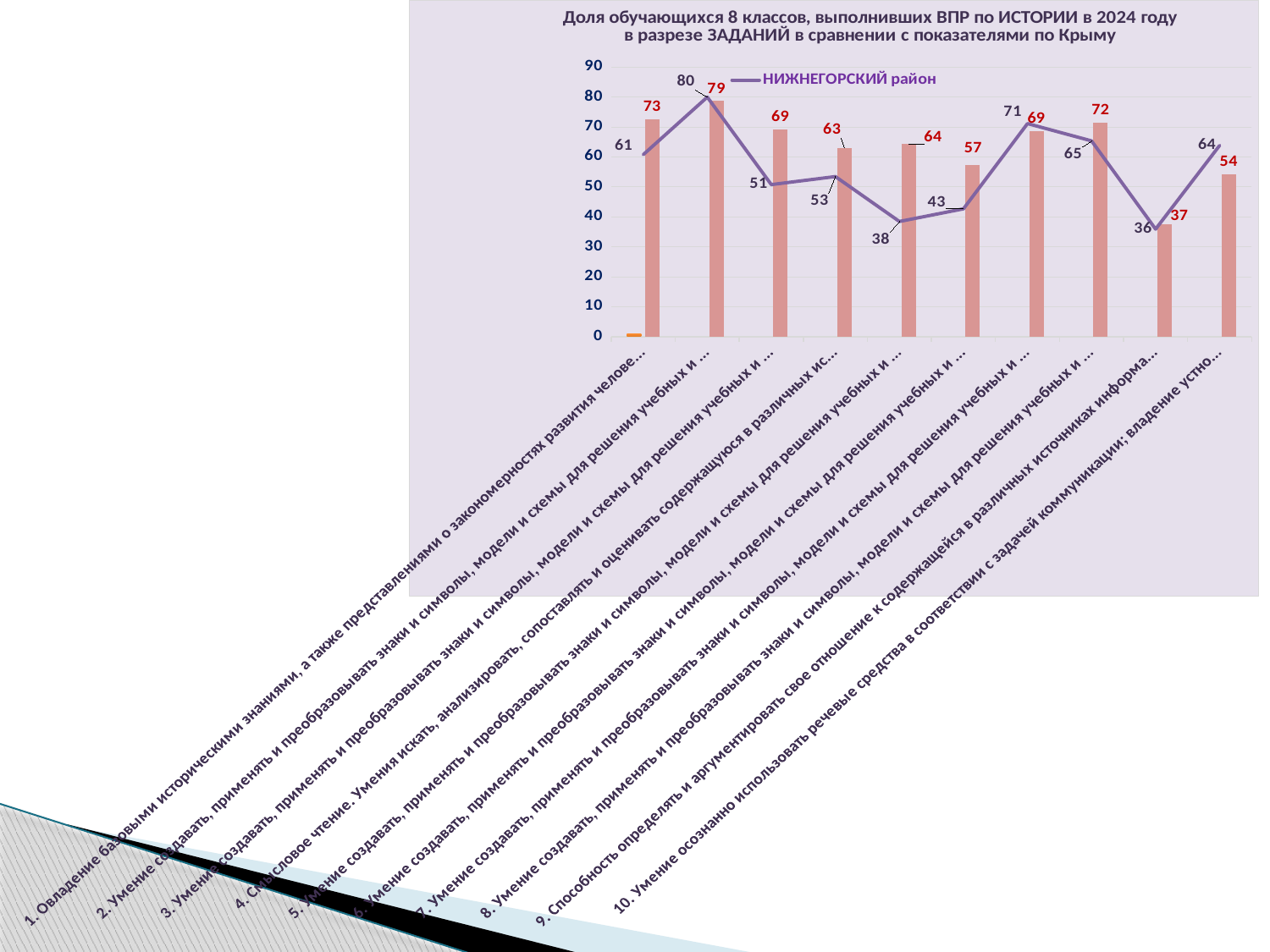
For which task is the НИЖНЕГОРСКИЙ район line value the highest? Task 2 What value does the НИЖНЕГОРСКИЙ район line show for task 1 (Овладение базовыми историческими знаниями...)? 61 For which task is the НИЖНЕГОРСКИЙ район line value the lowest? Task 9 What is the difference between the bar value (73) and the НИЖНЕГОРСКИЙ район line value (61) for task 1? 12 What is the red-labelled bar value for task 9 (Способность определять и аргументировать свое отношение...)? 37 What value does the НИЖНЕГОРСКИЙ район line show for task 2? 80 How many series does the legend list? 1 How many tasks (categories) are shown on the x axis? 10 For task 7, which is larger: the bar value or the НИЖНЕГОРСКИЙ район line value? The НИЖНЕГОРСКИЙ район line value (71) What is the name of the series shown in the legend? НИЖНЕГОРСКИЙ район For task 5, which is larger: the bar value or the НИЖНЕГОРСКИЙ район line value? The bar value (64) What kind of chart is this? A combined bar and line chart